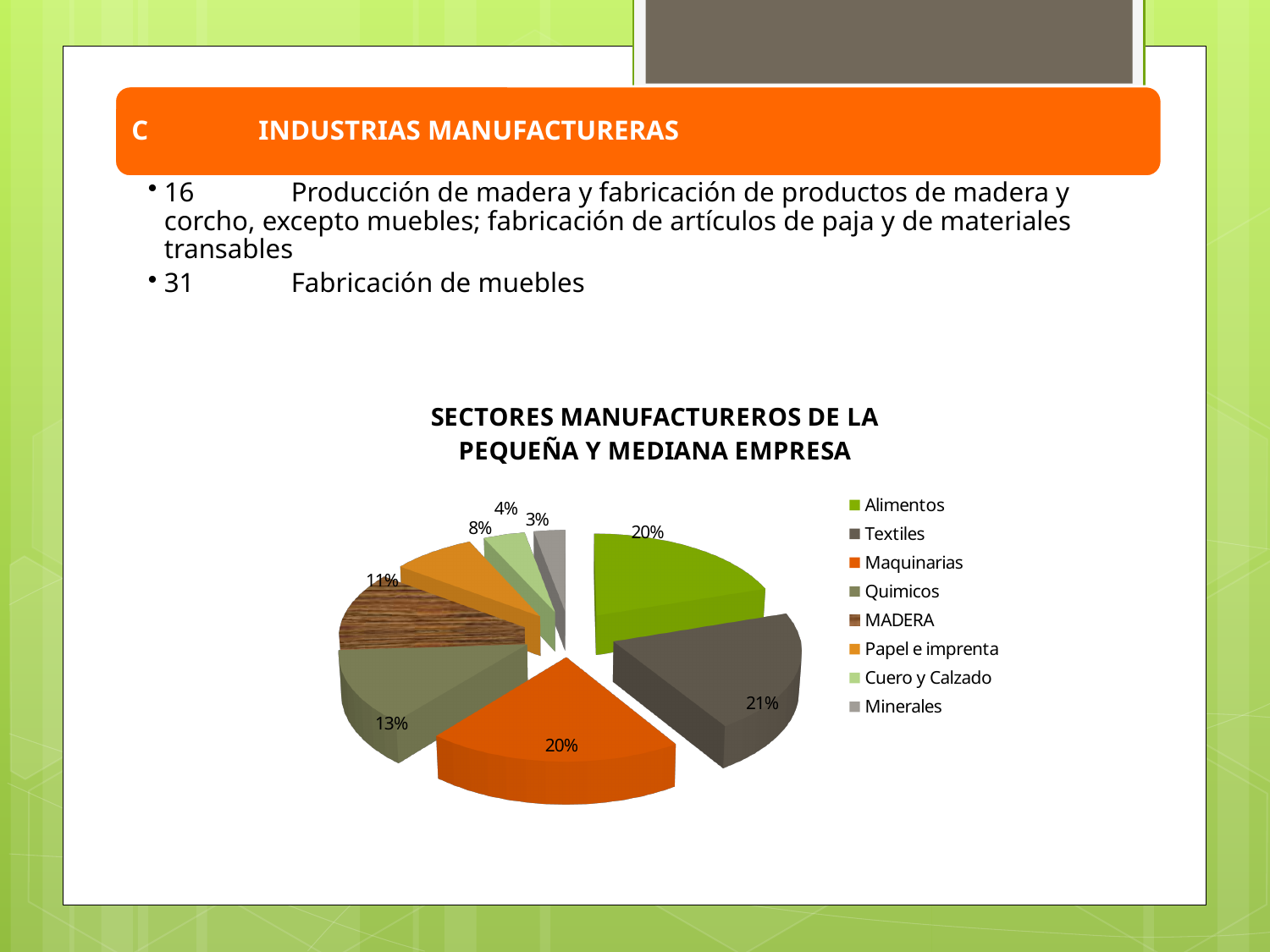
What share of the pie does Quimicos have? 13% Which sector has the largest share of the pie? Textiles What is the title of the chart? SECTORES MANUFACTUREROS DE LA PEQUEÑA Y MEDIANA EMPRESA What share of the pie does Papel e imprenta have? 8% What share of the pie does Textiles have? 21% How many sectors are shown in the pie chart? 8 What kind of chart is shown on the slide? pie chart What is the combined share of Alimentos and Maquinarias? 40% Which has a larger share, Cuero y Calzado or Minerales? Cuero y Calzado What is the difference between the shares of Quimicos and MADERA? 2% Which sector has the smallest share of the pie? Minerales